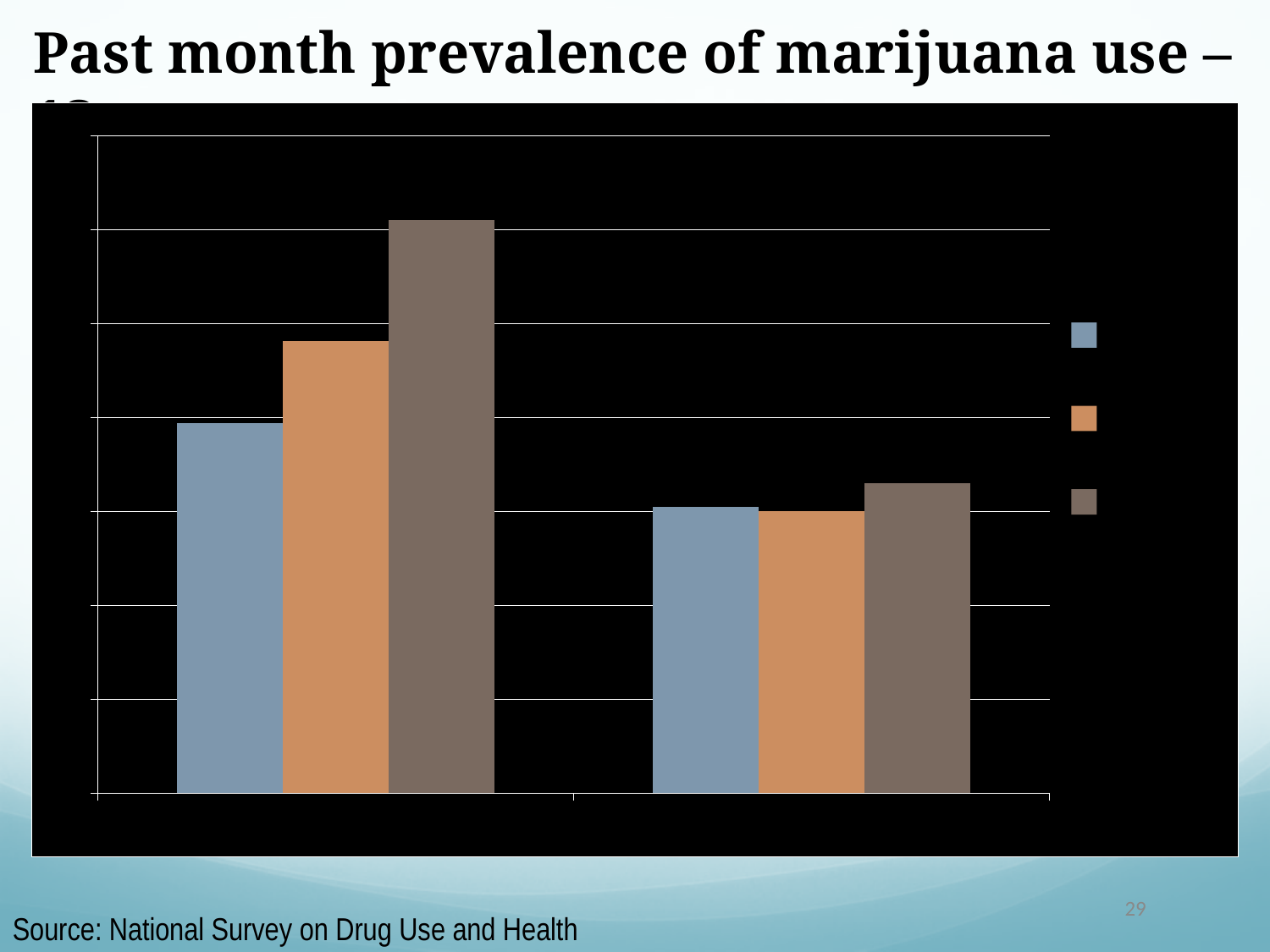
Which is larger: the orange bar in the left group or the orange bar in the right group? The orange bar in the left group How many bars are plotted in total on the chart? 6 In the right group of bars, which series has the tallest bar? The brown (third) series In the left group of bars, which series has the shortest bar? The blue (first) series What kind of chart is shown on the slide? Bar chart What source is cited for the chart's data? National Survey on Drug Use and Health In the left group of bars, which series has the tallest bar? The brown (third) series Which is larger: the blue bar in the left group or the blue bar in the right group? The blue bar in the left group What colour is the first series listed in the legend? Blue How many series does the legend list? 3 How many groups of bars are plotted along the x axis? 2 Which is larger: the brown bar in the left group or the brown bar in the right group? The brown bar in the left group